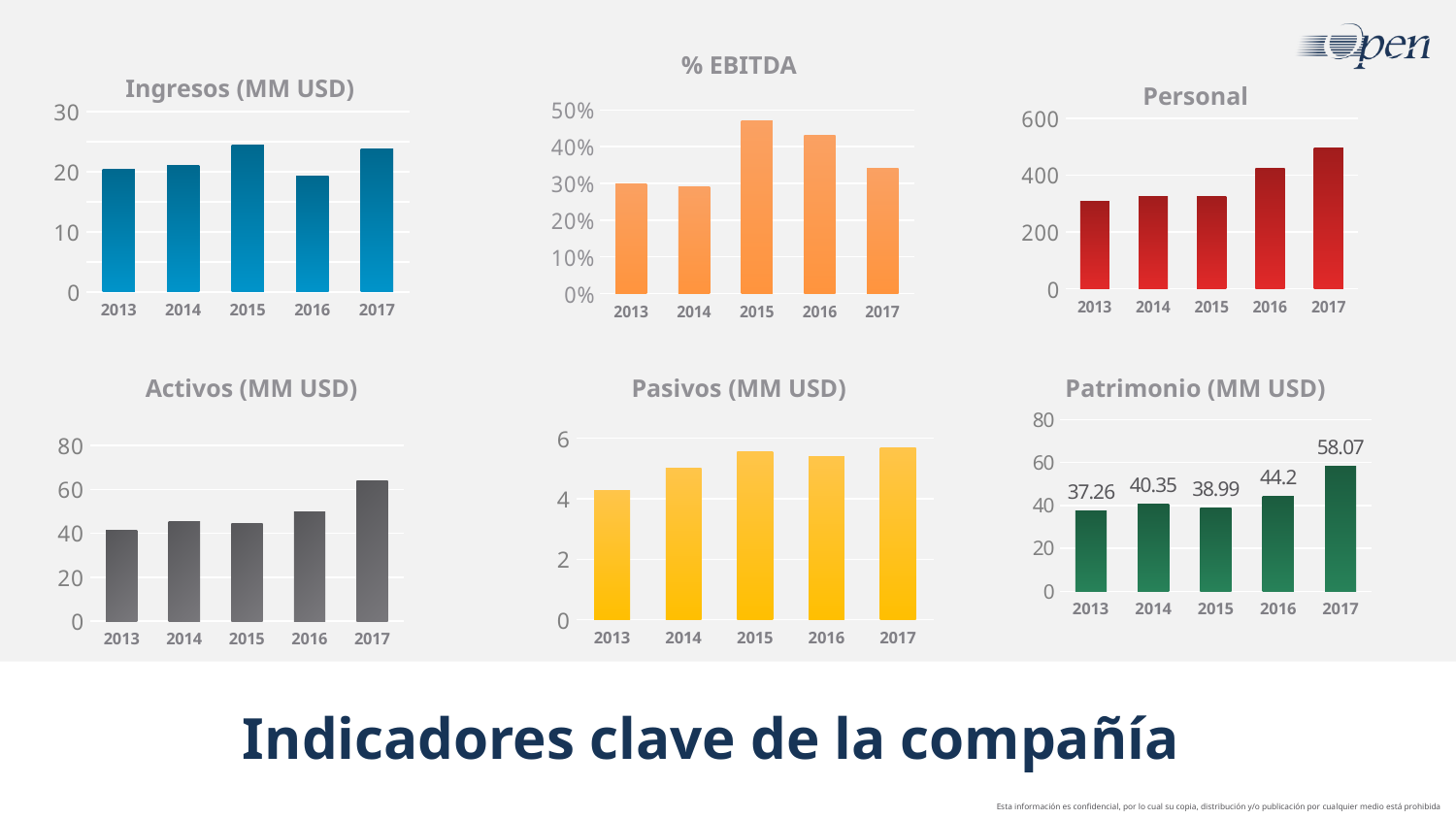
In the Patrimonio (MM USD) chart, what is the value for 2013? 37.26 In the % EBITDA chart, is the value for 2015 greater or less than 40%? greater In the Pasivos (MM USD) chart, which year has the lowest value? 2013 In the Activos (MM USD) chart, is the value for 2017 greater or less than 60? greater In the Patrimonio (MM USD) chart, which year has the lowest value? 2013 How many years are shown on the x axis of the Personal chart? 5 In the Ingresos (MM USD) chart, which year has the lowest value? 2016 In the % EBITDA chart, which year has the highest value? 2015 In the Patrimonio (MM USD) chart, what is the difference between the 2017 and 2016 values? 13.87 In the Patrimonio (MM USD) chart, what is the value for 2017? 58.07 What kind of chart is the Activos (MM USD) chart? Bar chart In the Personal chart, which year has the highest value? 2017